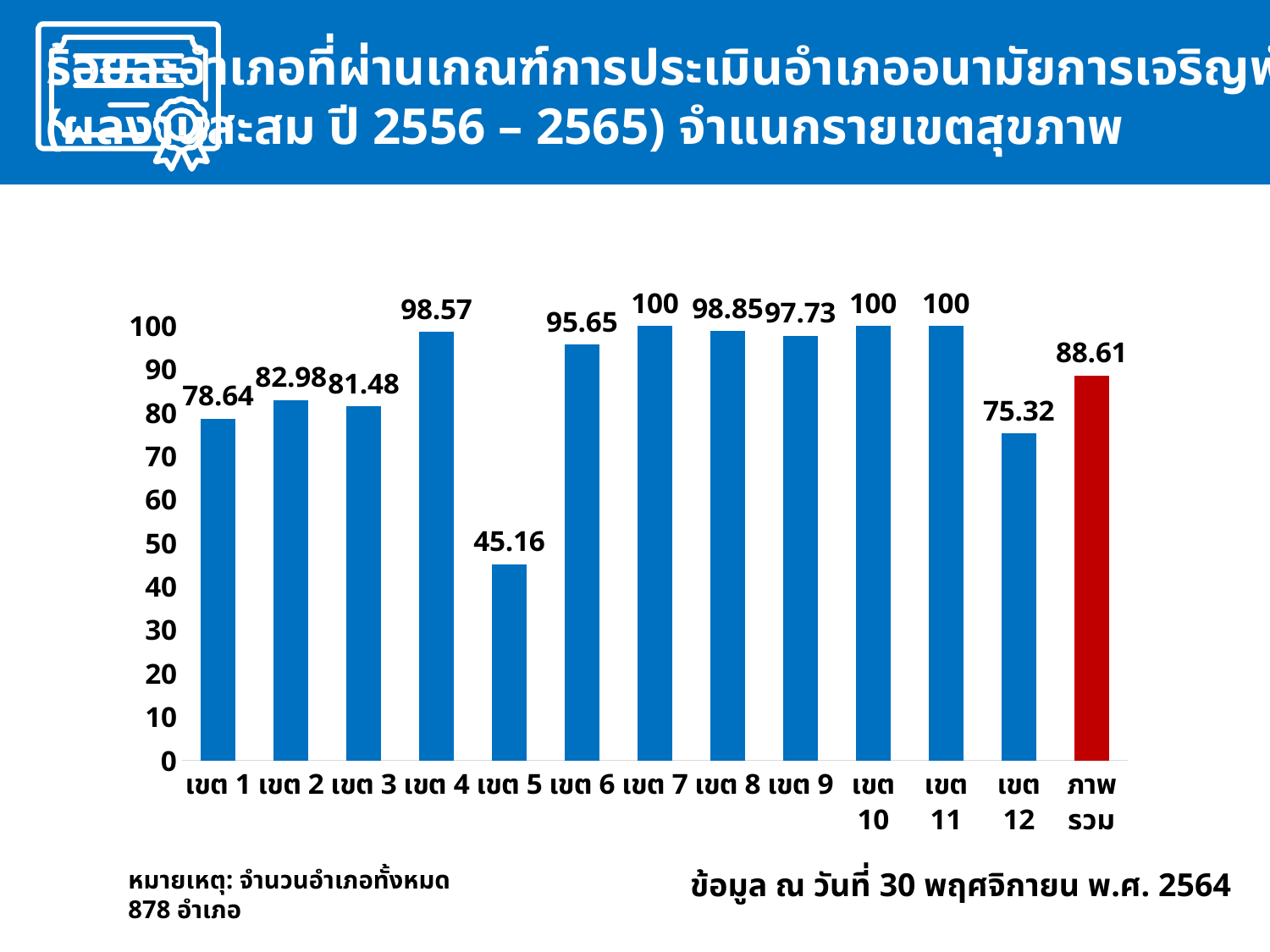
What is the difference between the values for ภาพรวม and เขต 12? 13.29 What kind of chart is shown on the slide? bar chart Which categories have a value of 100? เขต 7, เขต 10, เขต 11 What is the value for เขต 5? 45.16 Which has a larger value, เขต 1 or เขต 12? เขต 1 What is the value for เขต 12? 75.32 How many bars are shown in the chart? 13 Which category has the lowest value? เขต 5 What is the difference between the values for เขต 4 and เขต 5? 53.41 What is the value for ภาพรวม? 88.61 What is the value for เขต 4? 98.57 Is the value for เขต 5 greater or less than 50? less